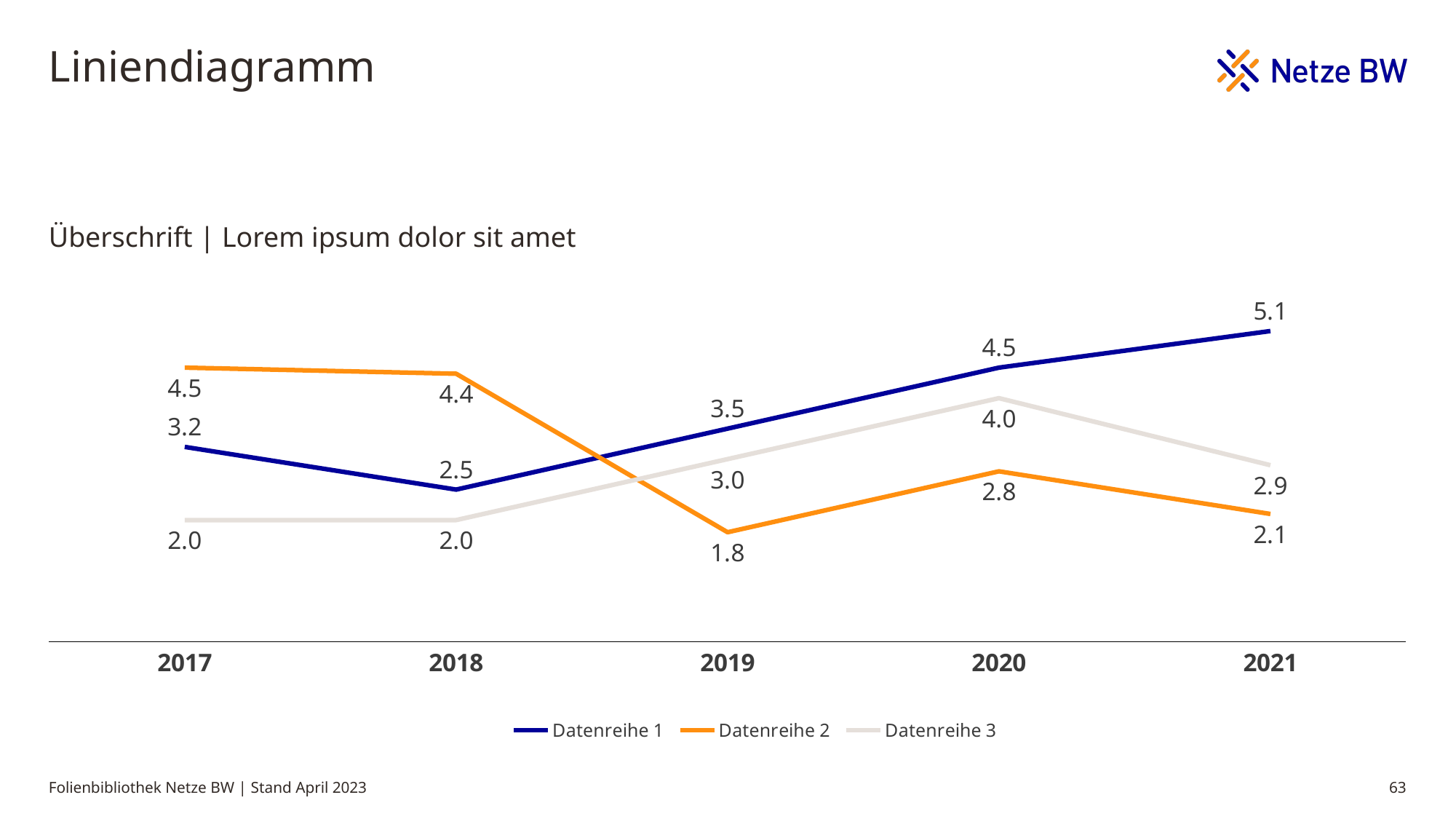
Does Datenreihe 1 rise or fall from 2018 to 2021? Rise In which year does Datenreihe 1 reach its highest value? 2021 What is the value of Datenreihe 2 in 2019? 1.8 What is the value of Datenreihe 3 in 2020? 4.0 Which series has the higher value in 2018, Datenreihe 1 or Datenreihe 2? Datenreihe 2 How many years are shown on the x axis? 5 What colour is the line for Datenreihe 2? Orange What is the value of Datenreihe 1 in 2021? 5.1 How many series does the legend list? 3 In which year does Datenreihe 2 have its lowest value? 2019 What is the difference between Datenreihe 1 and Datenreihe 2 in 2017? 1.3 What kind of chart is shown on the slide? Line chart